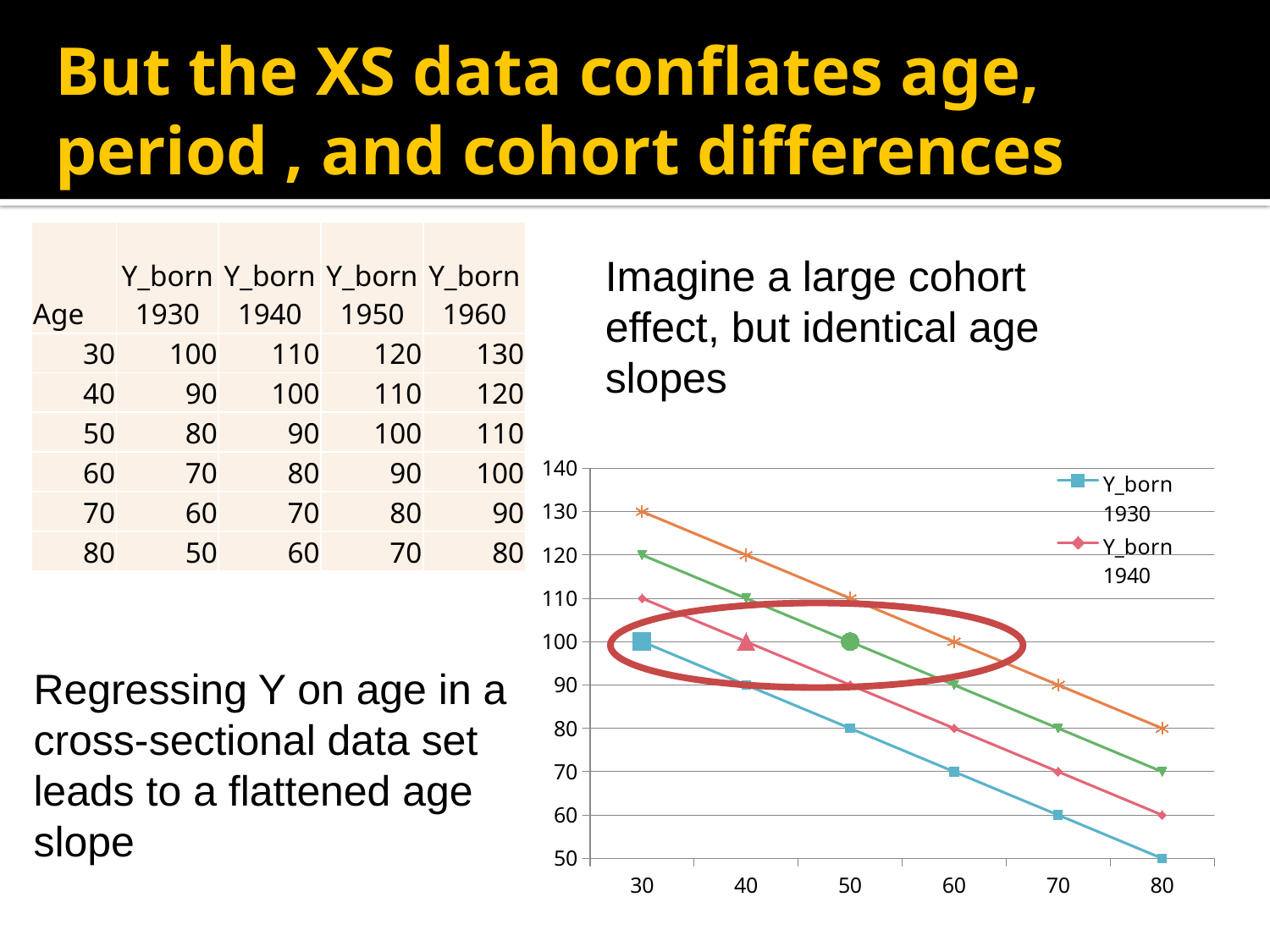
What is the difference between the Y_born 1940 and Y_born 1930 values at age 40? 10 How many series entries are visible in the chart's legend? 2 How many age values are plotted along the x axis of the chart? 6 What is the value for Y_born 1930 at age 30? 100 At age 60, which series has the larger value, Y_born 1930 or Y_born 1940? Y_born 1940 What is the value for Y_born 1940 at age 50? 90 Do the values for Y_born 1930 rise or fall as age increases along the x axis? fall What is the value for Y_born 1930 at age 80? 50 At which age is the value for Y_born 1940 highest? 30 Is the value for Y_born 1930 at age 70 greater or less than 70? less What kind of chart is shown on the slide? line chart At which age is the value for Y_born 1930 lowest? 80